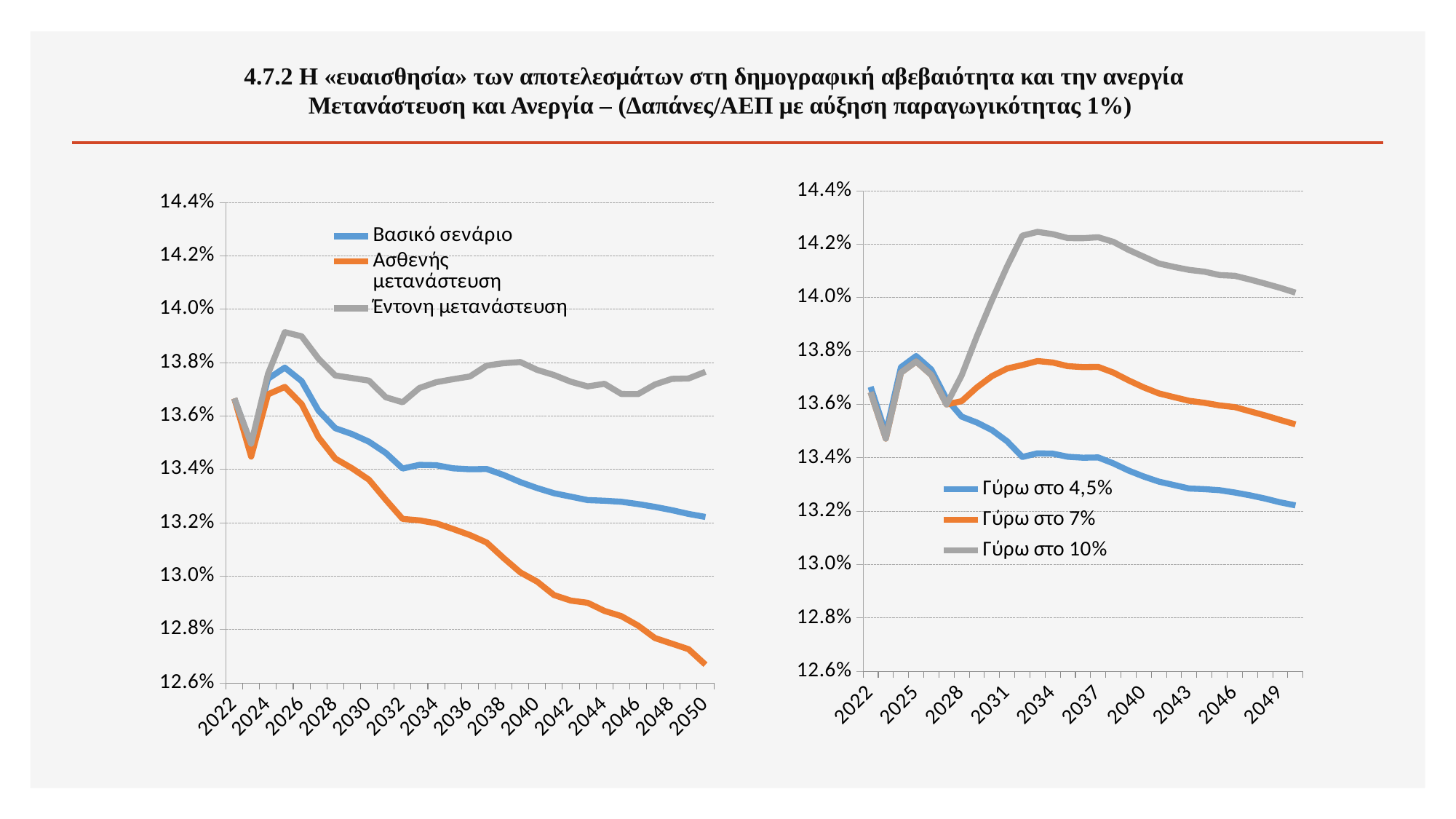
In the left chart, which series is shown in orange? Ασθενής μετανάστευση In the right chart, which series is the highest in 2034? Γύρω στο 10% What kind of chart is the left chart on the slide? line chart In the right chart, which is larger in 2049: the value for Γύρω στο 7% or the value for Γύρω στο 4,5%? Γύρω στο 7% In the left chart, does the Ασθενής μετανάστευση line rise or fall from 2026 to 2050? fall In the right chart, is the value for Γύρω στο 4,5% in 2049 greater or less than 13.4%? less How many series does the legend of the right chart list? 3 In the left chart, is the value for Βασικό σενάριο in 2050 greater or less than 13.0%? greater In the left chart, is the value for Ασθενής μετανάστευση in 2050 greater or less than 12.8%? less In the left chart, which series is the lowest in 2050? Ασθενής μετανάστευση In the left chart, which series is the highest in 2040? Έντονη μετανάστευση